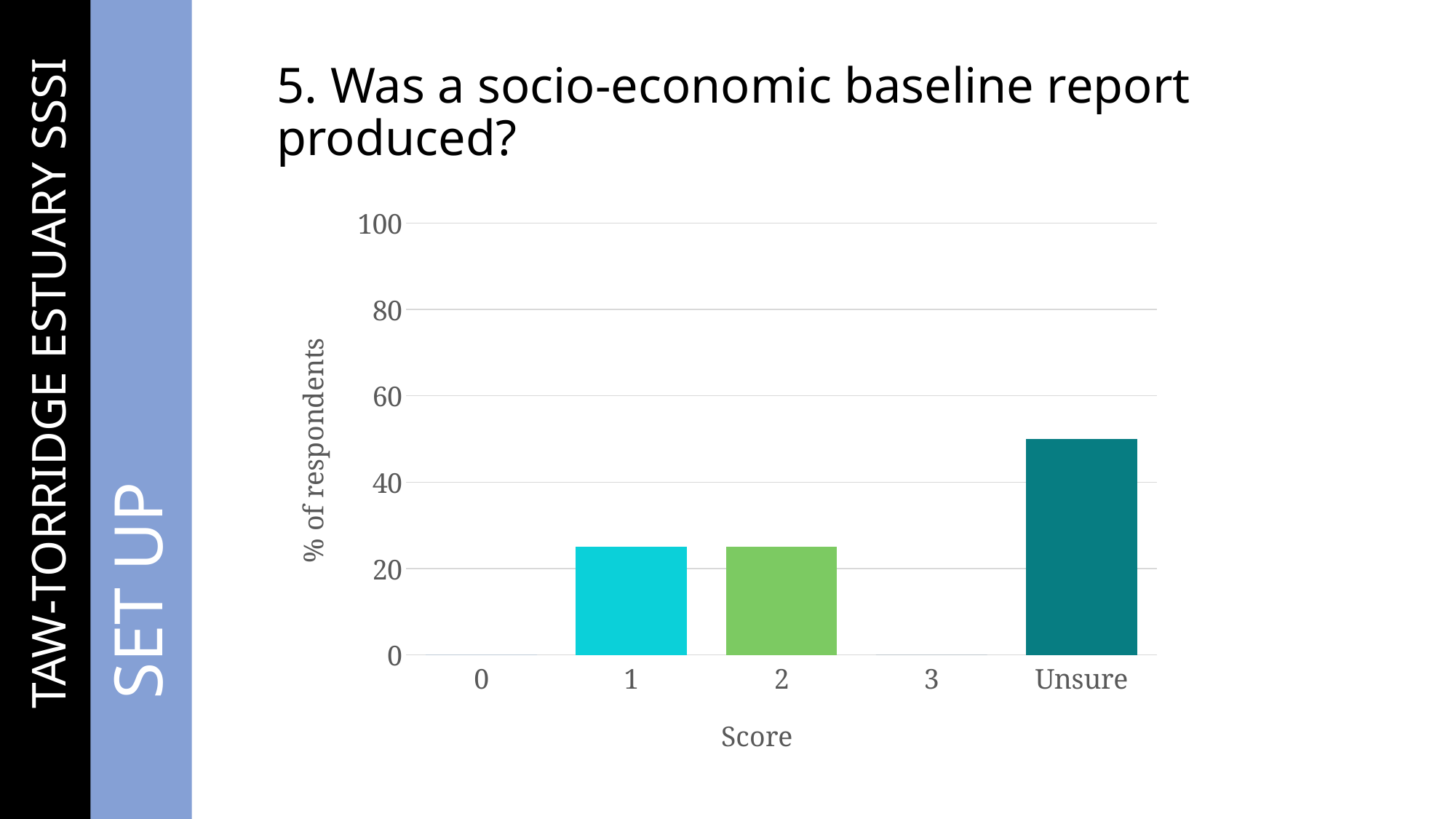
Which is larger, the value for Unsure or the value for score 1? Unsure Is the value for score 2 greater or less than 40? less Which category has the highest value in the chart? Unsure Which is larger, the value for score 2 or the value for score 3? score 2 What is the label of the x axis? Score Is the value for Unsure greater or less than 40? greater What kind of chart is shown on the slide? bar chart What is the label of the y axis? % of respondents Is the value for score 1 greater or less than 20? greater How many categories are shown on the x axis of the chart? 5